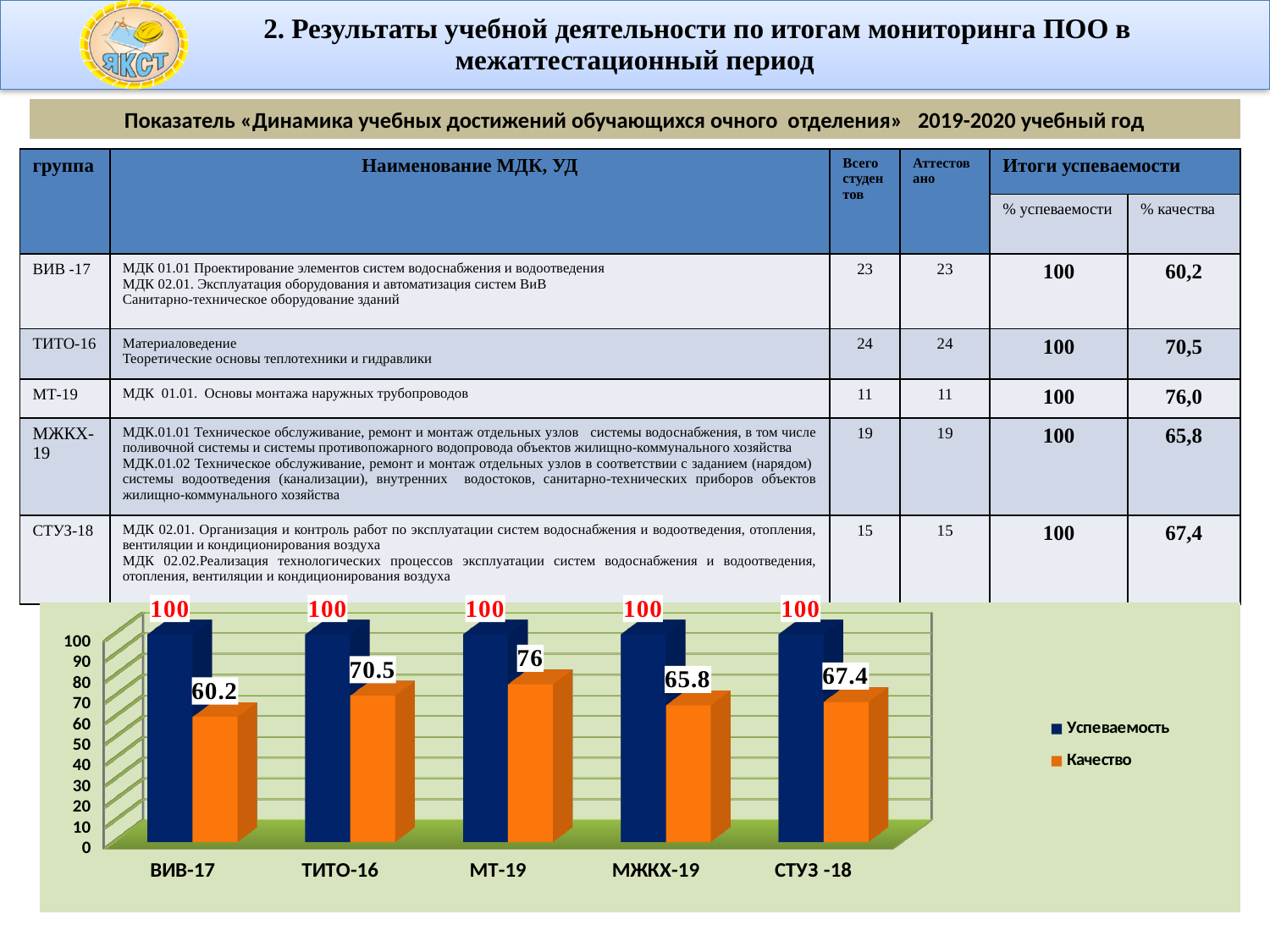
How many groups are shown on the x axis of the chart? 5 What is the value of Качество for МЖКХ-19? 65.8 What kind of chart is shown on the slide? Bar chart How many series does the chart legend list? 2 What is the difference between Успеваемость and Качество for ТИТО-16? 29.5 What is the value of Успеваемость for СТУЗ -18? 100 Which group has the highest Качество value? МТ-19 What is the value of Качество for ВИВ-17? 60.2 What is the value of Качество for МТ-19? 76 Which group has the lowest Качество value? ВИВ-17 Which is larger, the Качество value for СТУЗ -18 or for МЖКХ-19? СТУЗ -18 Which colour represents the Качество series in the chart? Orange